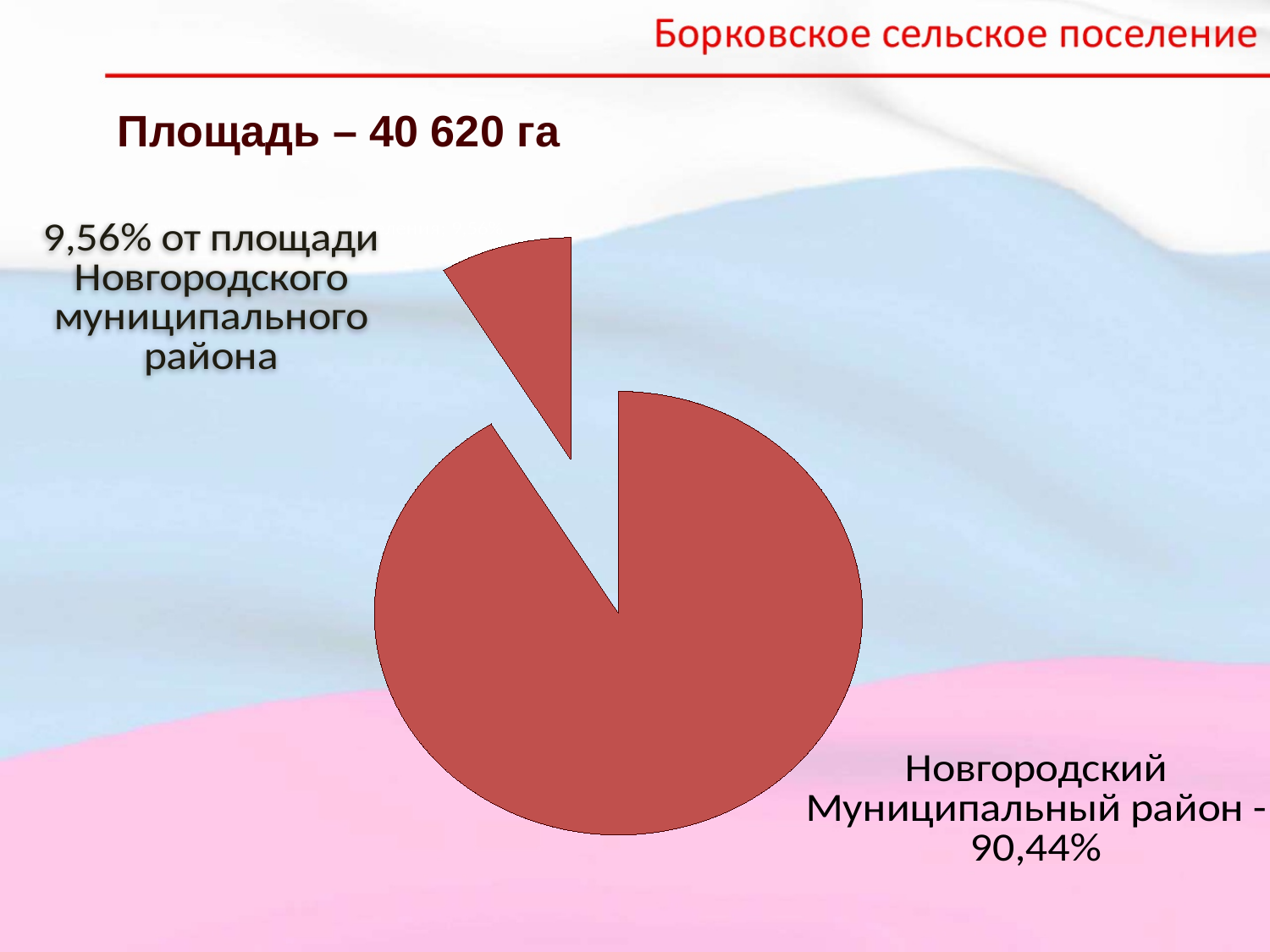
What area (Площадь) is stated on the slide above the chart? 40 620 га What kind of chart is shown on the slide? pie chart How many slices does the pie chart have? 2 What do the two pie slices add up to? 100% What is the difference in percentage points between the 90,44% slice and the 9,56% slice? 80,88 Which slice of the pie is the largest? Новгородский Муниципальный район (90,44%) Which is larger: the slice labelled 90,44% or the slice labelled 9,56%? the slice labelled 90,44% What share of the pie does the small separated slice represent? 9,56% Is the share of the small separated slice greater or less than 10%? less Which slice of the pie is the smallest? the 9,56% slice (share of the Новгородский муниципальный район area) What colour are the slices of the pie chart? red What share of the pie is labelled for Новгородский Муниципальный район? 90,44%